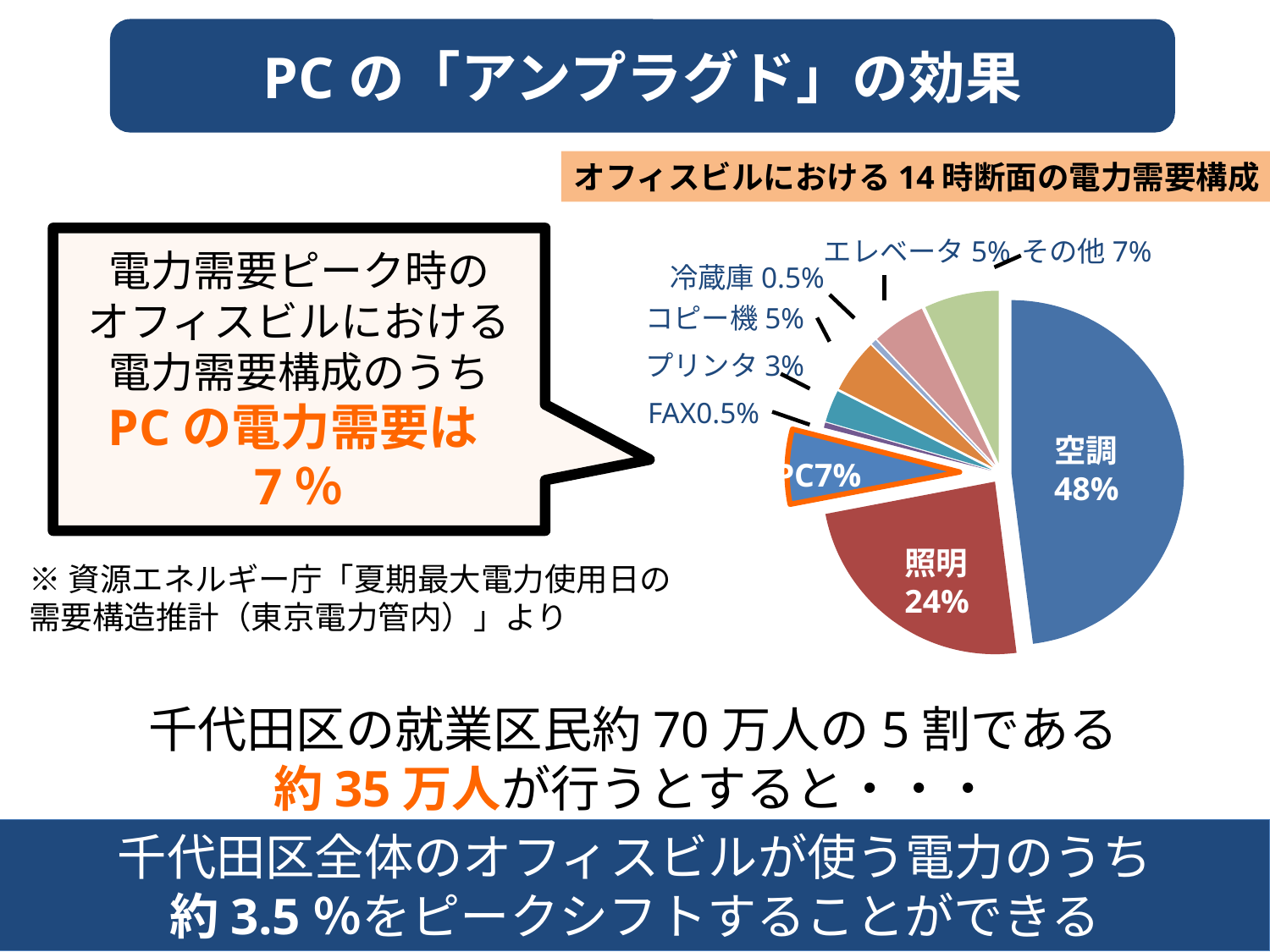
How many categories are shown in the pie chart? 9 Which category is larger in the pie chart, 照明 or PC? 照明 What is the value shown for プリンタ in the pie chart? 3% What kind of chart is shown on the slide? pie chart What is the difference between the shares of PC and プリンタ? 4% What share of the pie does 照明 account for? 24% What is the title of the pie chart? オフィスビルにおける14時断面の電力需要構成 Which category has the largest slice of the pie? 空調 What is the value shown for PC in the pie chart? 7% What is the difference between the shares of 空調 and 照明? 24% What is the value shown for 冷蔵庫 in the pie chart? 0.5% What share of the pie does 空調 account for? 48%